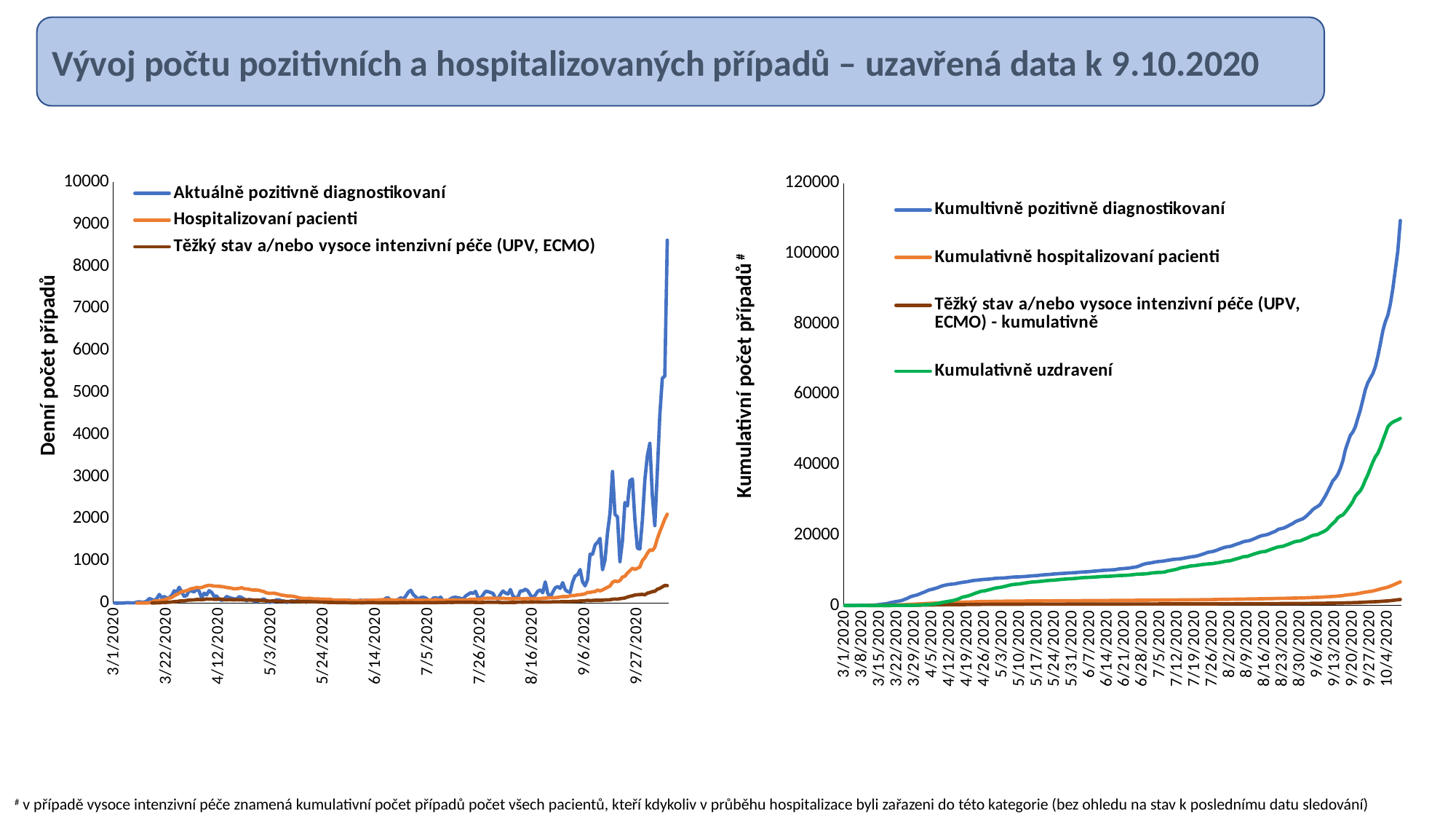
What kind of chart is the right chart on the slide? line chart In the right chart, is the final value of the 'Kumulativně hospitalizovaní pacienti' series greater or less than 20000? less In the right chart, which series reaches the highest value? Kumultivně pozitivně diagnostikovaní In the right chart, at the end of the period, which is larger: 'Kumultivně pozitivně diagnostikovaní' or 'Kumulativně uzdravení'? Kumultivně pozitivně diagnostikovaní In the right chart, is the final value of the 'Kumulativně uzdravení' series greater or less than 40000? greater What is the y-axis title of the left chart? Denní počet případů What kind of chart is the left chart on the slide? line chart In the right chart, is the final value of the 'Kumultivně pozitivně diagnostikovaní' series greater or less than 100000? greater How many series does the legend of the right chart list? 4 How many series does the legend of the left chart list? 3 In the right chart, does the 'Kumultivně pozitivně diagnostikovaní' series rise or fall along the x axis? rise